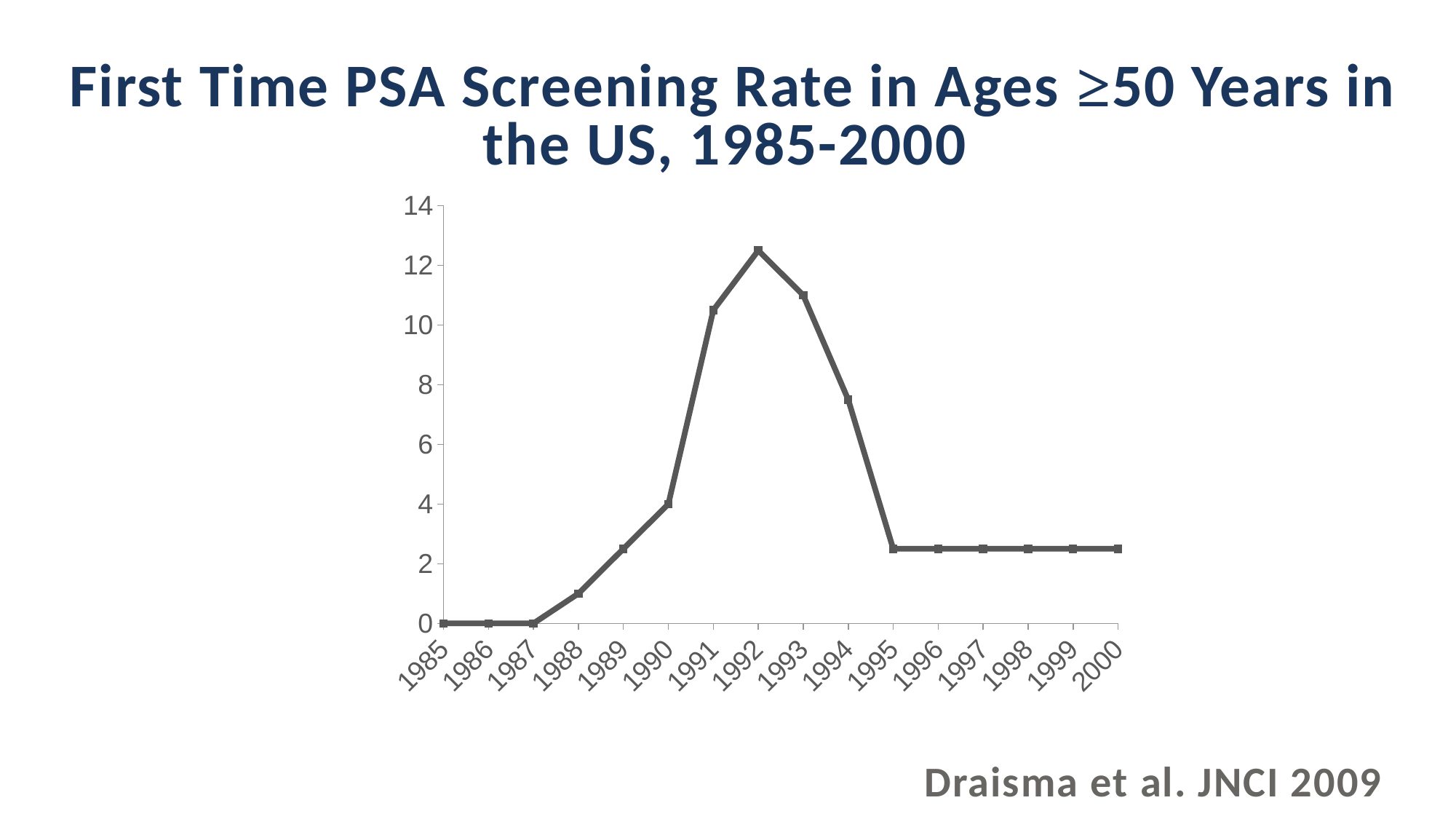
What kind of chart is shown on the slide? line chart What is the value for 1990? 4 Does the screening rate rise or fall between 1992 and 1995? fall Is the value for 1991 greater or less than 10? greater What is the value for 1985? 0 Is the value for 1994 greater or less than 8? less In which year is the screening rate highest? 1992 Is the value for 1992 greater or less than 12? greater What is the title of the chart? First Time PSA Screening Rate in Ages ≥50 Years in the US, 1985-2000 Which year has the larger value, 1991 or 1994? 1991 Does the screening rate rise or fall between 1987 and 1992? rise How many years are plotted along the x axis? 16